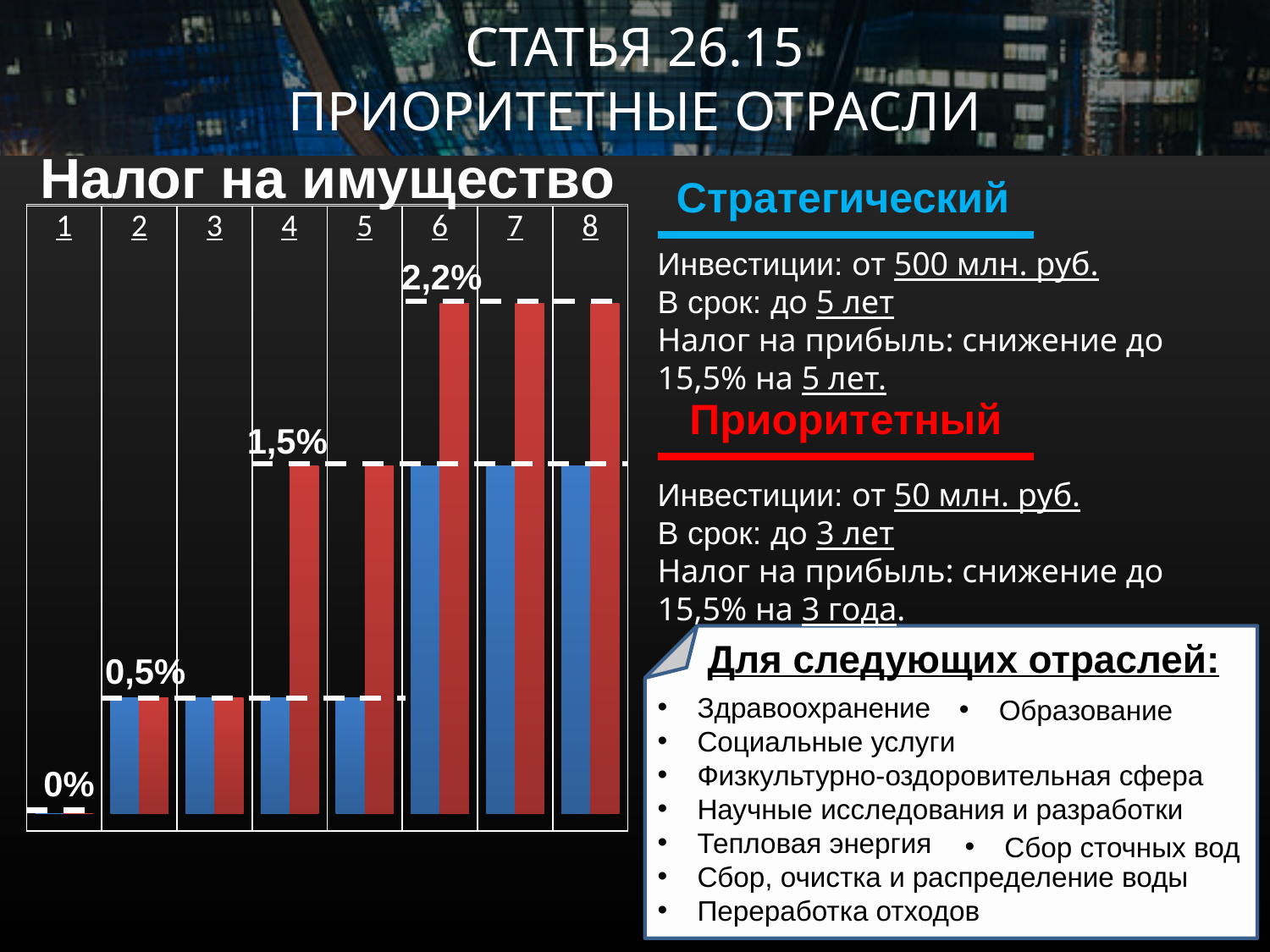
In the 'Налог на имущество' chart, is the red bar for year 5 greater or less than 0,5%? greater What is the value of the blue bar for year 2 in the 'Налог на имущество' chart? 0,5% Do the red bars in the 'Налог на имущество' chart rise or fall from year 2 to year 8? rise What is the value shown for year 1 in the 'Налог на имущество' chart? 0% How many categories (years) are shown on the x axis of the 'Налог на имущество' chart? 8 What is the value of the red bar for year 6 in the 'Налог на имущество' chart? 2,2% In the 'Налог на имущество' chart, which bar is higher for year 4, the blue one or the red one? the red one What is the title of the chart on the left of the slide? Налог на имущество In the 'Налог на имущество' chart, what is the difference between the red bar and the blue bar for year 7? 0,7% What is the value of the red bar for year 4 in the 'Налог на имущество' chart? 1,5% What is the value of the blue bar for year 6 in the 'Налог на имущество' chart? 1,5% What kind of chart is shown under the heading 'Налог на имущество'? bar chart